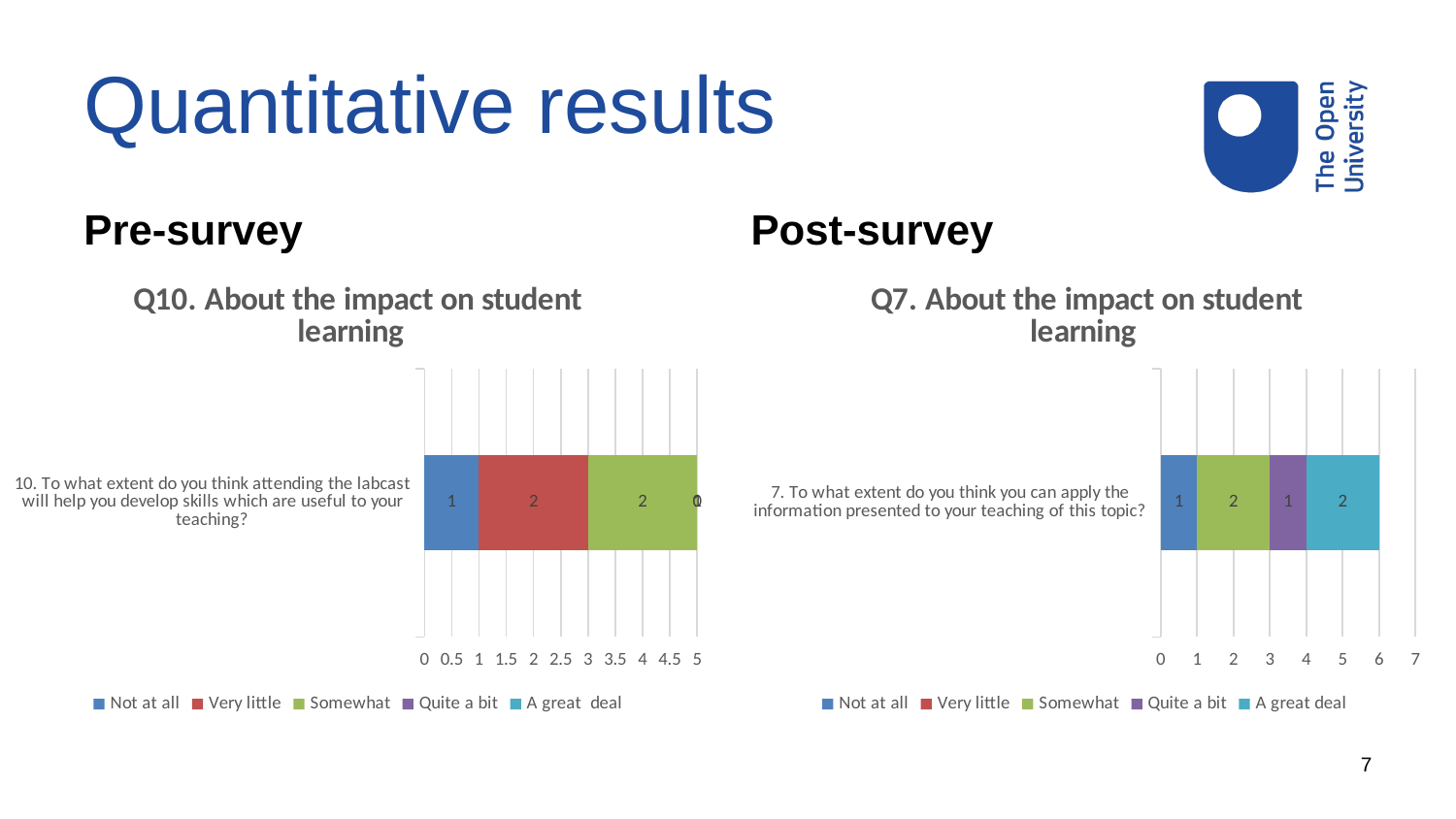
In the Pre-survey chart (Q10), what is the value for 'Very little'? 2 What kind of chart is the Pre-survey chart (Q10)? Stacked bar chart In the Pre-survey chart (Q10), what is the difference between 'Very little' and 'Not at all'? 1 In the Post-survey chart (Q7), what is the total of the stacked bar? 6 In the Post-survey chart (Q7), what colour represents 'A great deal'? Teal/light blue In the Pre-survey chart (Q10), what is the value for 'Not at all'? 1 How many series does the legend of the Post-survey chart (Q7) list? 5 What is the title of the chart under the Post-survey heading? Q7. About the impact on student learning In the Post-survey chart (Q7), what is the value for 'A great deal'? 2 In the Post-survey chart (Q7), which is larger, 'Somewhat' or 'Not at all'? Somewhat In the Post-survey chart (Q7), what is the value for 'Quite a bit'? 1